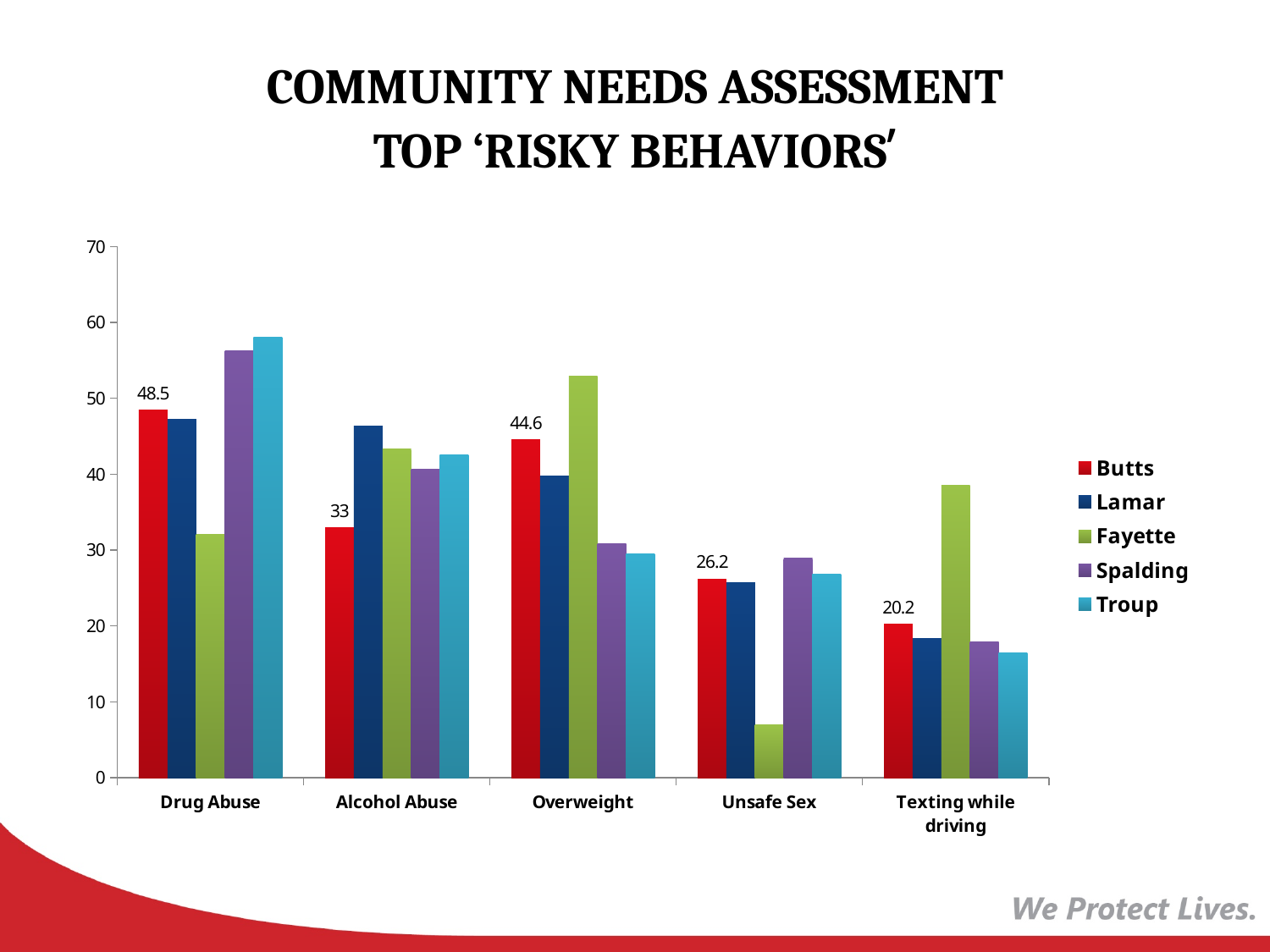
For the Overweight category, which is larger: Fayette or Spalding? Fayette Is the value for Troup in the Drug Abuse category greater or less than 50? greater What is the value for Butts in the Drug Abuse category? 48.5 What is the difference between the Butts values for Overweight and Unsafe Sex? 18.4 How many series does the legend list? 5 What is the value for Butts in the Alcohol Abuse category? 33 Is the value for Fayette in the Unsafe Sex category greater or less than 10? less In which category does Butts have its highest value? Drug Abuse What kind of chart is shown on the slide? Bar chart In which category does Butts have its lowest value? Texting while driving What is the value for Butts in the Texting while driving category? 20.2 What is the difference between the Butts values for Drug Abuse and Alcohol Abuse? 15.5